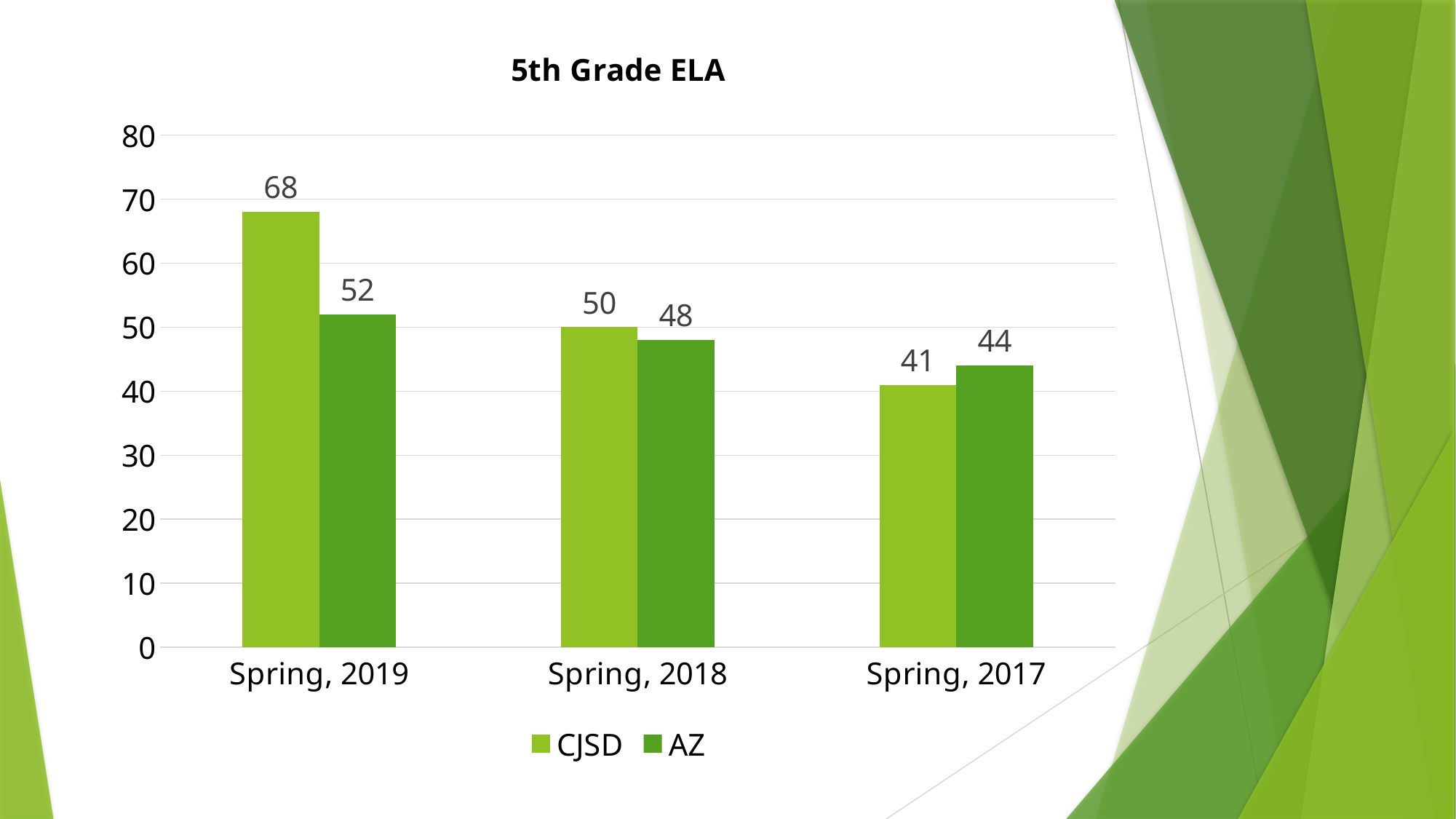
Which category has the highest CJSD value? Spring, 2019 What kind of chart is shown on the slide? bar chart What is the title of the chart? 5th Grade ELA Which is larger for Spring, 2017, the CJSD value or the AZ value? AZ Is the AZ value for Spring, 2019 greater or less than 60? less How many categories are shown on the x axis? 3 What is the AZ value for Spring, 2018? 48 What is the difference between the CJSD and AZ values for Spring, 2019? 16 What is the CJSD value for Spring, 2019? 68 How many series does the legend list? 2 What is the CJSD value for Spring, 2017? 41 Which category has the lowest AZ value? Spring, 2017